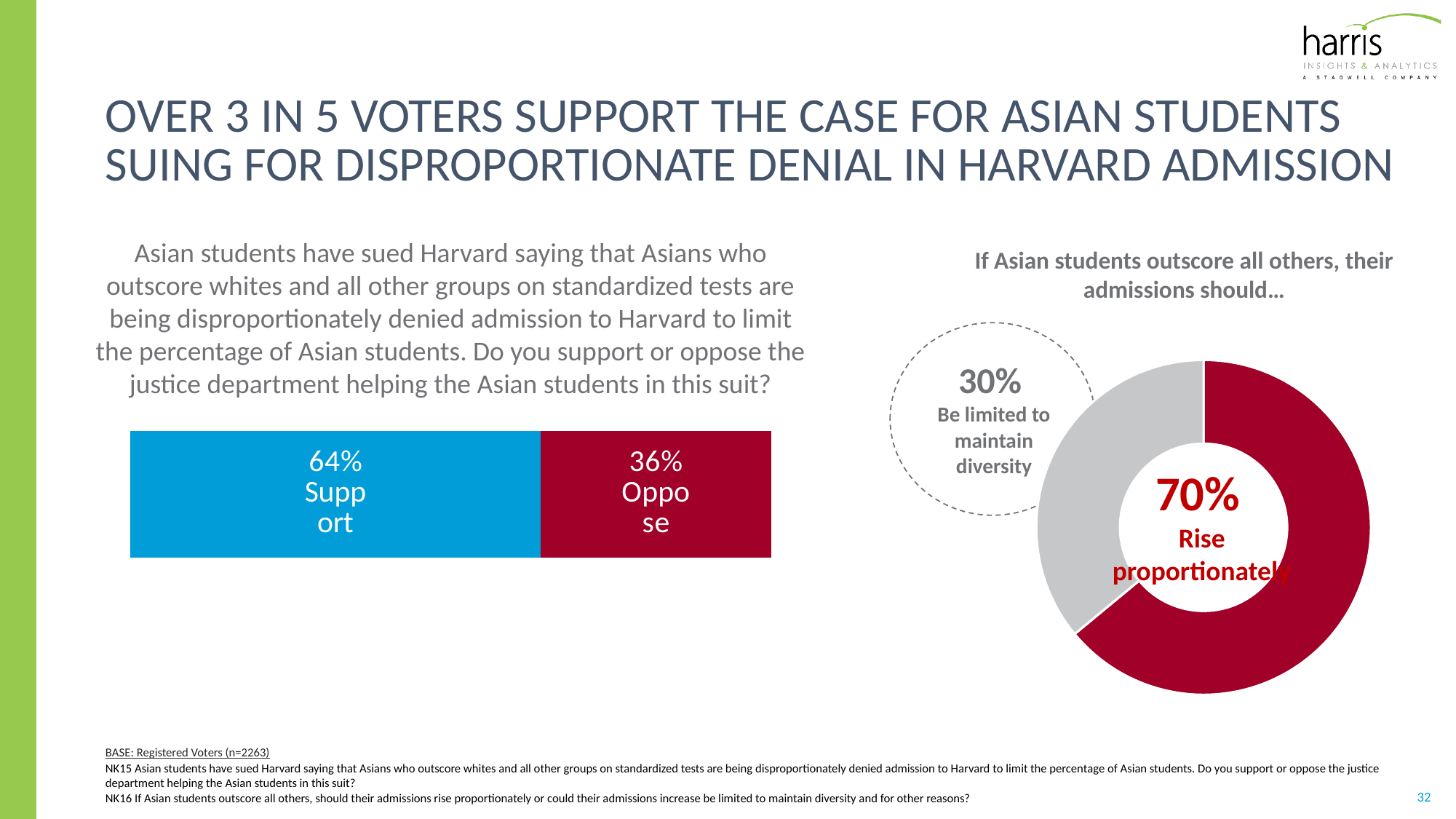
How many categories does the donut chart on the right show? 2 In the donut chart on the right, what share says admissions should be limited to maintain diversity? 30% In the donut chart titled 'If Asian students outscore all others, their admissions should…', what share says admissions should rise proportionately? 70% In the left-hand bar chart, what is the total of the Support and Oppose segments? 100% In the left-hand bar chart, what colour is the Support segment? Blue In the left-hand bar chart, what percentage of voters oppose? 36% In the left-hand bar chart, what is the difference between the Support and Oppose percentages? 28 percentage points In the left-hand bar chart, what percentage of voters support the justice department helping the Asian students in this suit? 64% In the donut chart on the right, which response is the largest? Rise proportionately In the left-hand bar chart, which is larger, Support or Oppose? Support What kind of chart is shown on the left side of the slide? Bar chart In the donut chart on the right, what is the difference between 'Rise proportionately' and 'Be limited to maintain diversity'? 40 percentage points